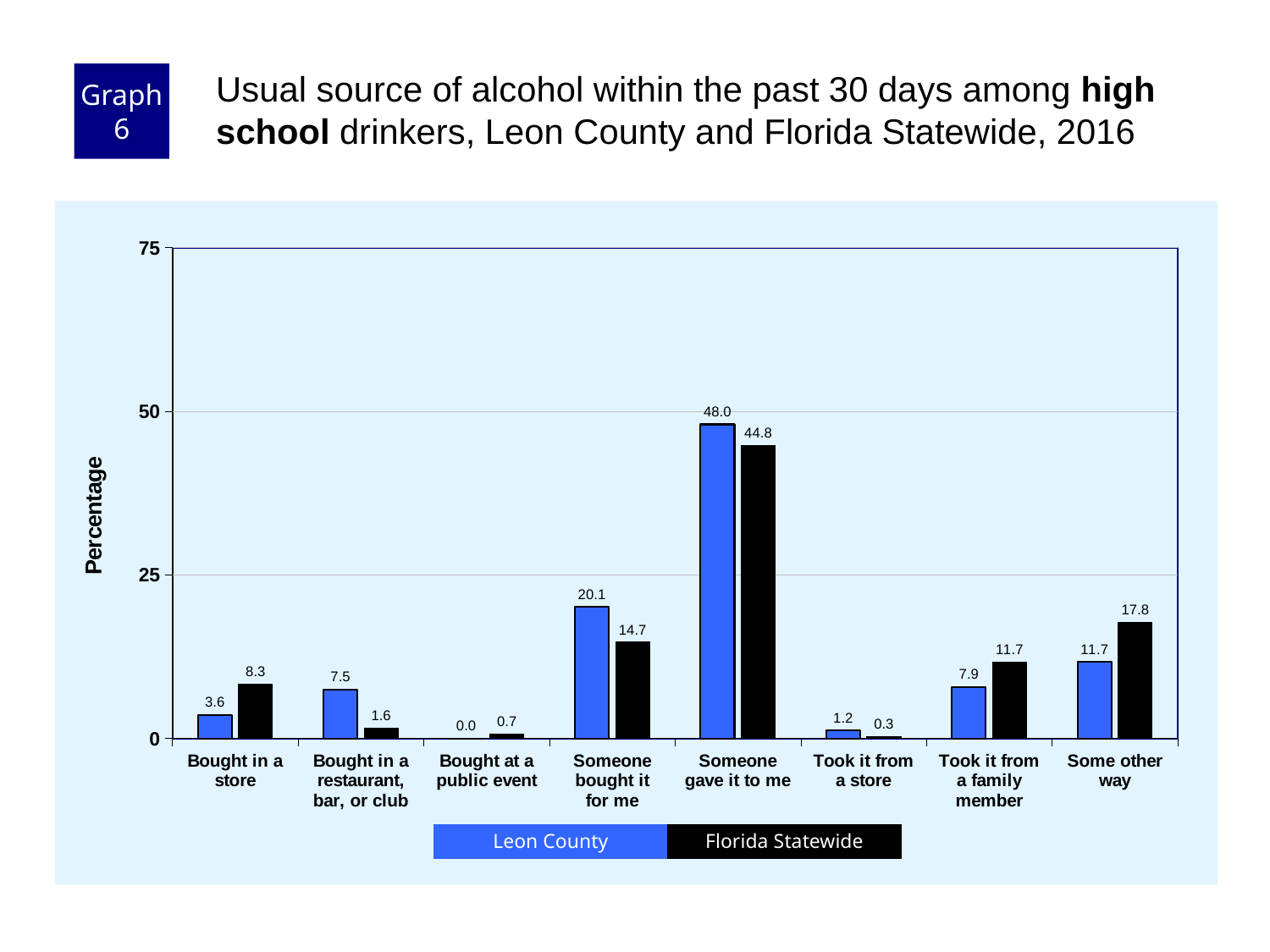
Is the Leon County value for "Someone gave it to me" greater or less than 25? greater How many categories are shown on the x axis? 8 For "Bought in a restaurant, bar, or club", which is larger: Leon County or Florida Statewide? Leon County What is the difference between the Leon County and Florida Statewide values for "Someone bought it for me"? 5.4 How many series does the legend list? 2 What is the label on the y axis? Percentage Which category has the lowest Leon County value? Bought at a public event Which category has the highest Florida Statewide value? Someone gave it to me What kind of chart is shown on the slide? Bar chart What is the Leon County value for "Someone gave it to me"? 48.0 What is the Leon County value for "Bought at a public event"? 0.0 What is the Florida Statewide value for "Some other way"? 17.8